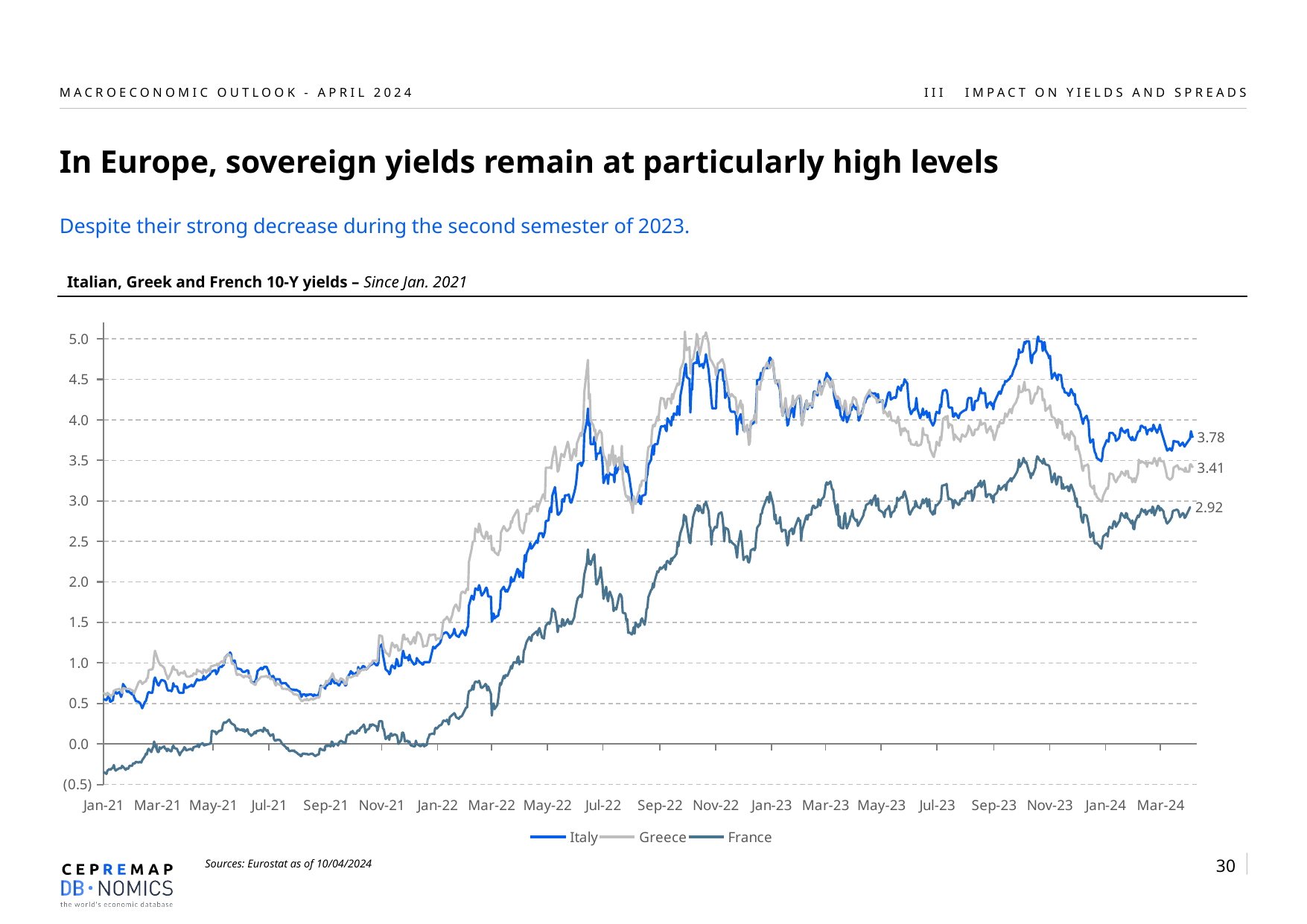
What is the latest value shown for France's 10-Y yield at the right end of the chart? 2.92 What is the latest value shown for Greece's 10-Y yield at the right end of the chart? 3.41 Overall, does the French 10-Y yield rise or fall from Jan-21 to Mar-24? rise What is the difference between the latest Italian and French yields shown on the chart? 0.86 What is the difference between the latest Italian and Greek yields shown on the chart? 0.37 At the end of the series, is the Greek yield higher or lower than the French yield? higher Is the French yield in Jan-21 greater or less than 0.0? less What is the latest value shown for Italy's 10-Y yield at the right end of the chart? 3.78 Which country has the highest 10-Y yield at the end of the series shown? Italy Which country has the lowest 10-Y yield at the end of the series shown? France How many series does the legend list? 3 What kind of chart is shown on the slide? line chart